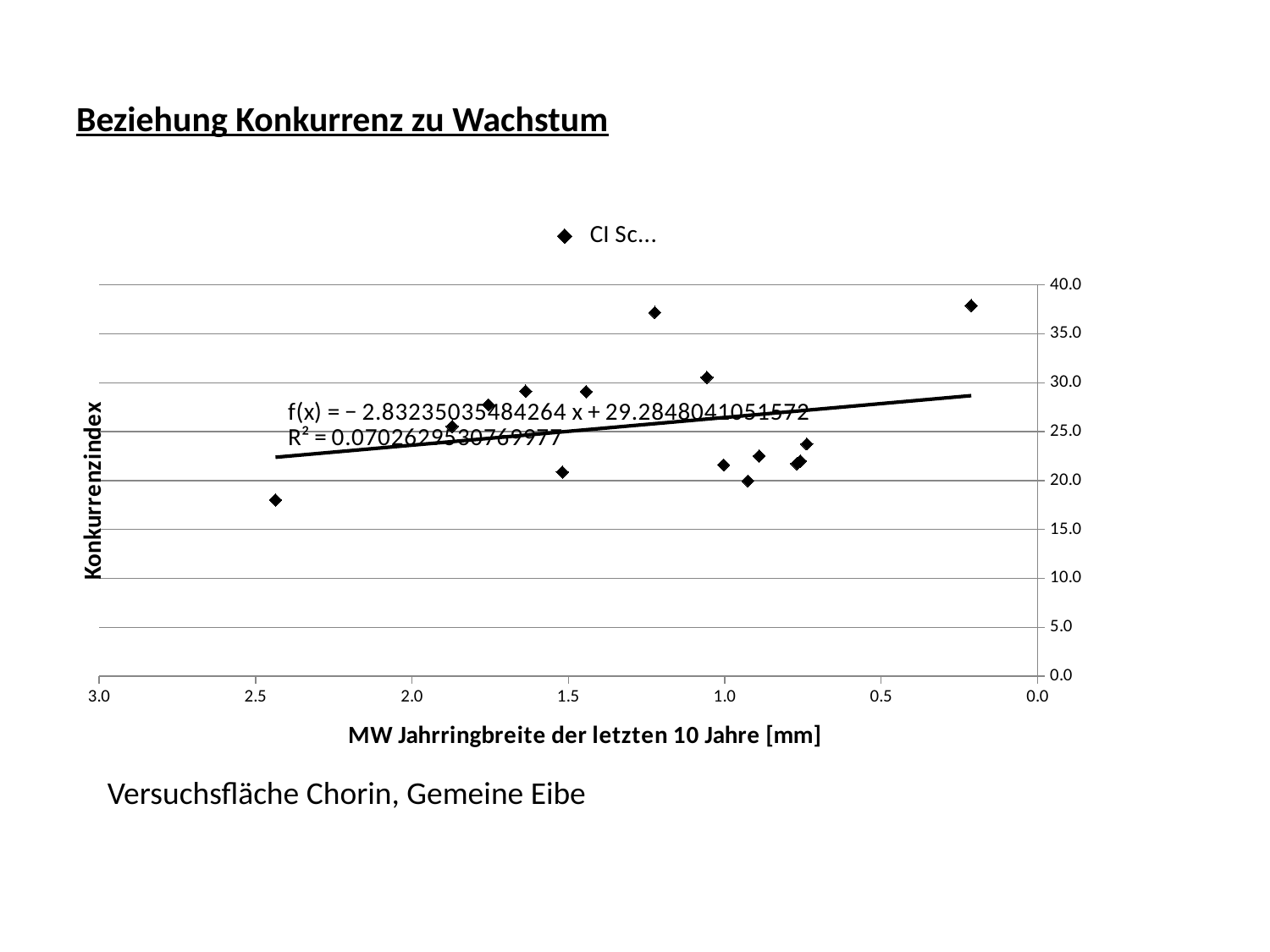
What is the maximum value shown on the y axis? 40.0 According to the fitted trendline, does the Konkurrenzindex rise or fall as the ring width increases? fall Is the Konkurrenzindex of the point at about 2.4 mm ring width greater or less than 20.0? less What is the title of the x axis? MW Jahrringbreite der letzten 10 Jahre [mm] What is the title of the y axis? Konkurrenzindex How many series does the legend list? 1 What is the slope of the fitted line f(x) printed on the chart? − 2.83235035484264 Is the Konkurrenzindex of the point at about 1.2 mm ring width greater or less than 35.0? greater What is the intercept of the fitted line f(x) printed on the chart? 29.2848041051572 What is the R² value printed on the chart? 0.0702629530769977 What kind of chart is shown on the slide? scatter chart Is the Konkurrenzindex of the point at about 0.2 mm ring width greater or less than 35.0? greater